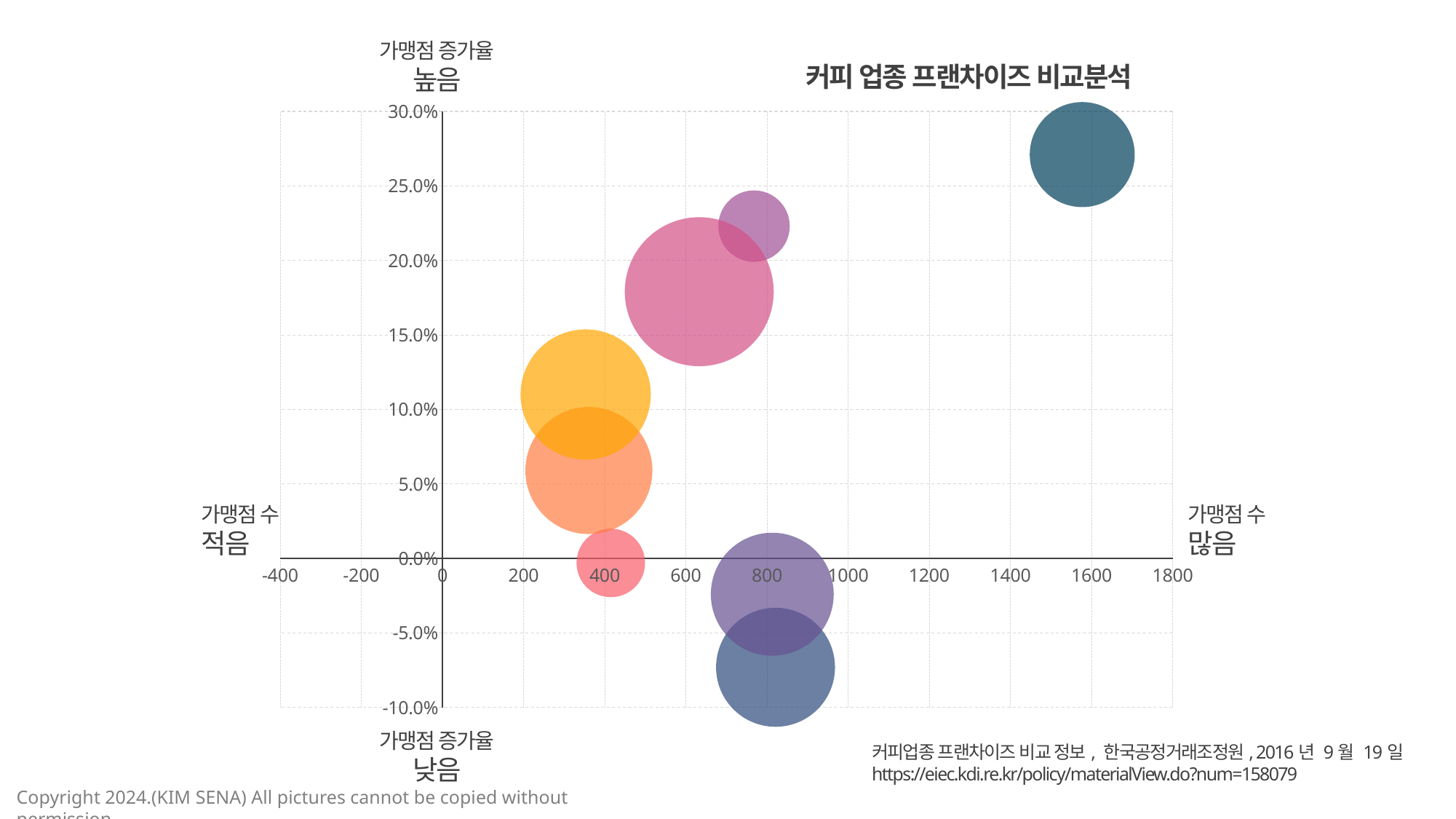
What is the title of the chart? 커피 업종 프랜차이즈 비교분석 Is the 가맹점 증가율 of the dark teal bubble in the top right greater or less than 25.0%? greater Is the 가맹점 수 (x-axis value) of the dark teal bubble in the top right greater or less than 1400? greater Which bubble has the highest 가맹점 증가율 (y-axis value)? The dark teal bubble in the top right Which bubble has a larger 가맹점 수: the dark teal bubble in the top right or the yellow bubble? The dark teal bubble in the top right Is the 가맹점 증가율 of the large pink bubble greater or less than 15.0%? greater What kind of chart is shown on the slide? Bubble chart What does the horizontal axis of the chart represent? 가맹점 수 Which bubble has the lowest 가맹점 증가율 (y-axis value)? The blue-gray bubble at the bottom How many bubbles are plotted on the chart? 8